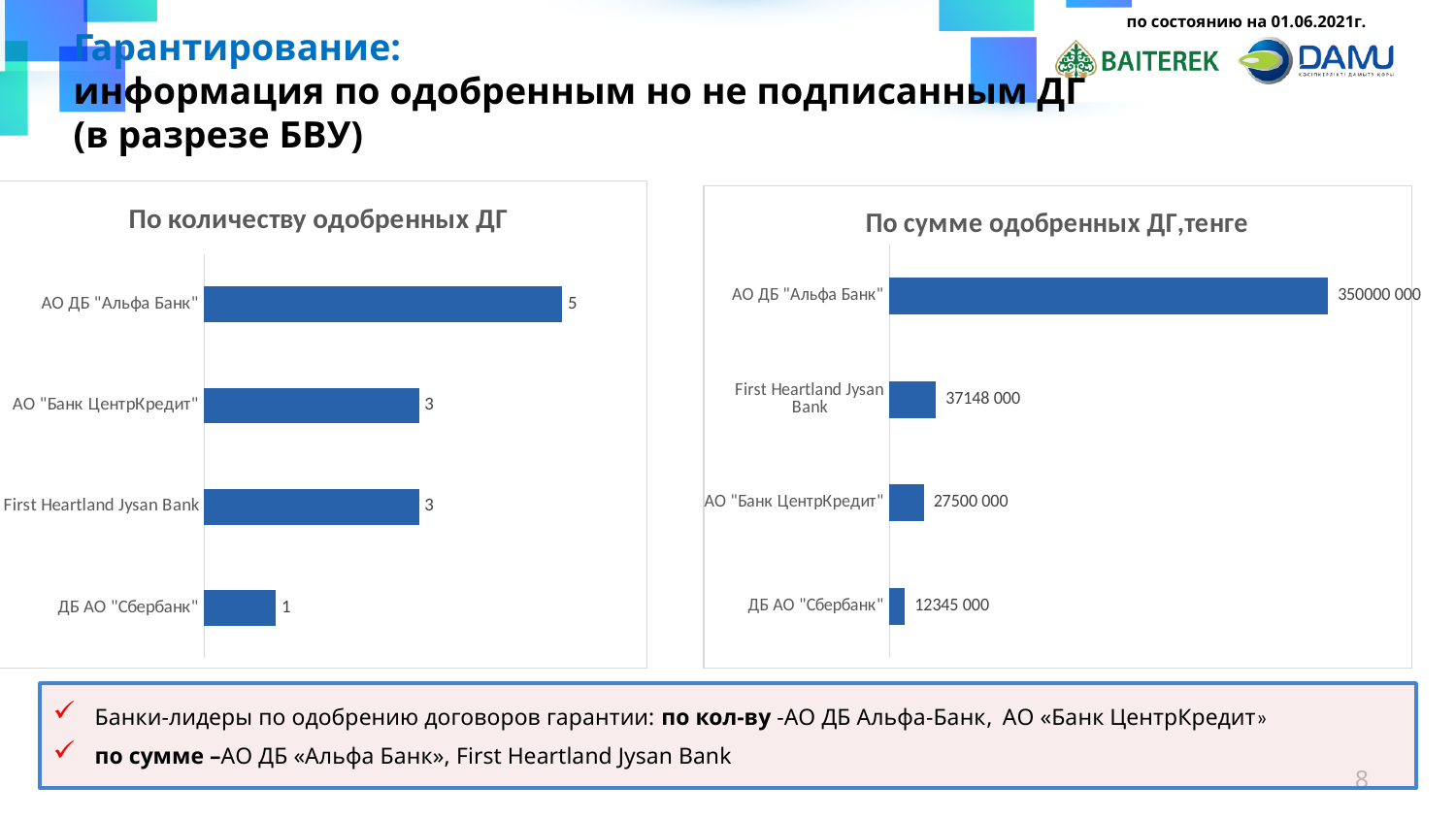
In the chart "По сумме одобренных ДГ,тенге", what is the value for First Heartland Jysan Bank? 37148 000 In the chart "По сумме одобренных ДГ,тенге", which is larger: First Heartland Jysan Bank or АО "Банк ЦентрКредит"? First Heartland Jysan Bank In the chart "По количеству одобренных ДГ", what is the difference between АО ДБ "Альфа Банк" and АО "Банк ЦентрКредит"? 2 In the chart "По сумме одобренных ДГ,тенге", which bank has the lowest value? ДБ АО "Сбербанк" In the chart "По количеству одобренных ДГ", how many banks are shown? 4 In the chart "По количеству одобренных ДГ", which bank has the highest value? АО ДБ "Альфа Банк" What type of chart is the chart "По сумме одобренных ДГ,тенге"? Bar chart In the chart "По сумме одобренных ДГ,тенге", what is the value for АО "Банк ЦентрКредит"? 27500 000 In the chart "По количеству одобренных ДГ", what is the value for ДБ АО "Сбербанк"? 1 What is the title of the chart on the left side of the slide? По количеству одобренных ДГ In the chart "По количеству одобренных ДГ", what is the value for АО ДБ "Альфа Банк"? 5 In the chart "По сумме одобренных ДГ,тенге", what is the difference between АО ДБ "Альфа Банк" and ДБ АО "Сбербанк"? 337655 000